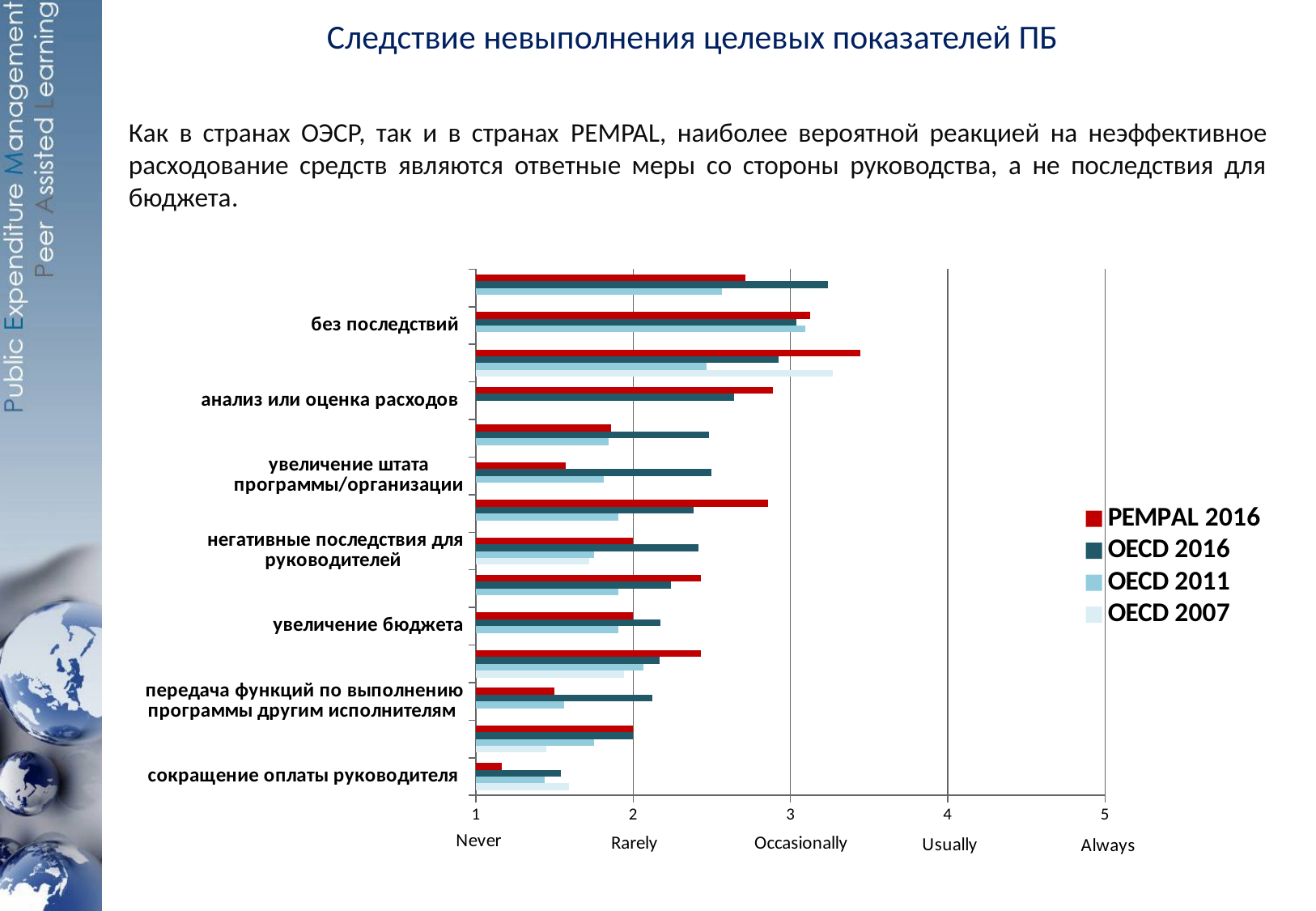
Does any bar on the chart reach the value 4? No What is the highest value shown on the chart's horizontal axis? 5 What word labels the value 5 on the horizontal axis? Always How many series does the chart legend list? 4 What kind of chart is shown on the slide? bar chart Is the longest bar on the chart greater or less than 3? greater What word labels the value 1 on the horizontal axis? Never